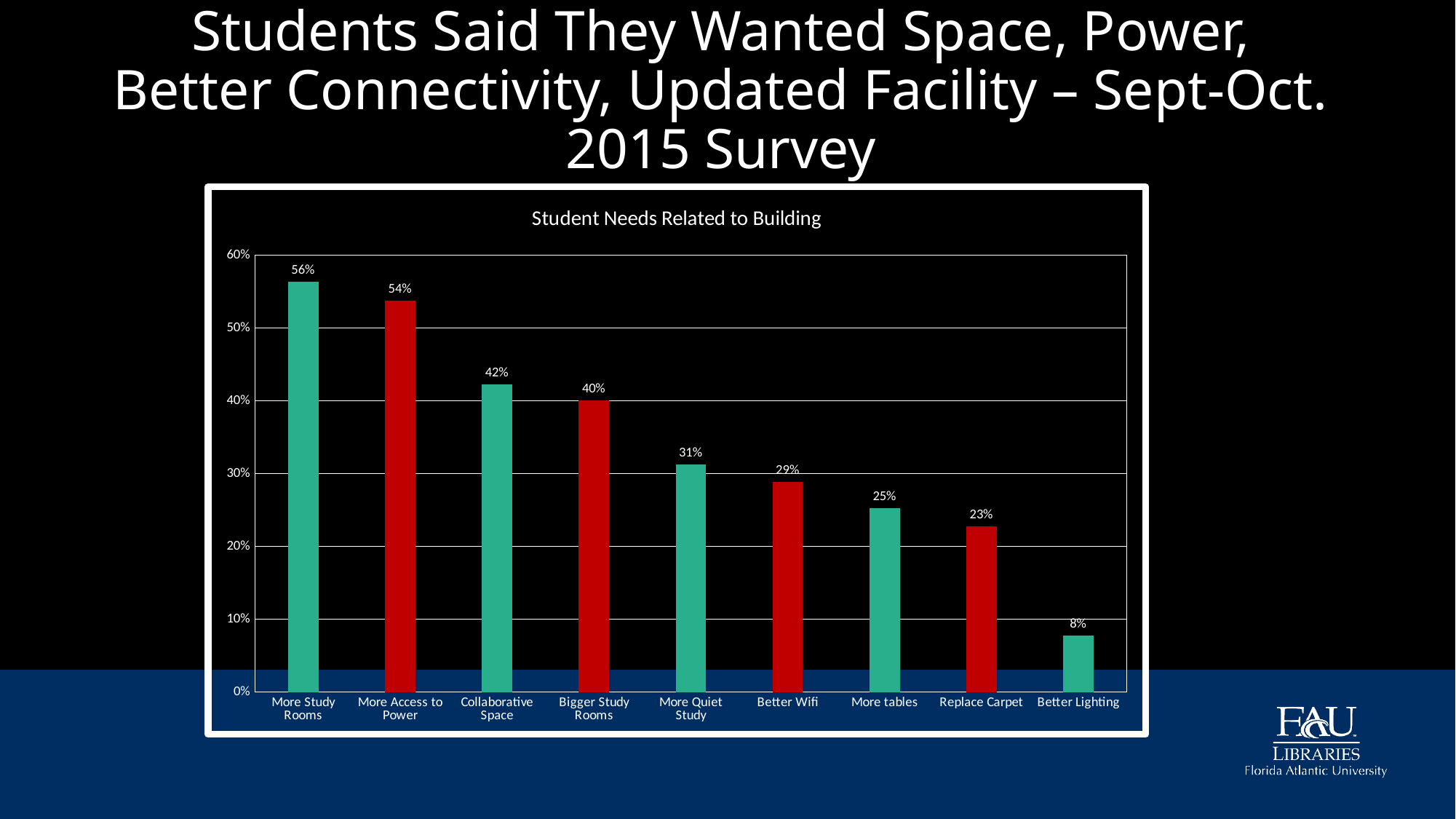
What is the title of the chart? Student Needs Related to Building Is the value for Collaborative Space greater or less than 40%? greater What is the difference between the values for Collaborative Space and Bigger Study Rooms? 2% What is the difference between the values for More Access to Power and Better Lighting? 46% What is the value for Replace Carpet? 23% What is the value for More Study Rooms? 56% How many categories are shown on the x axis? 9 Which category has the highest value? More Study Rooms What is the value for Better Wifi? 29% Which is larger, the value for More Quiet Study or the value for More tables? More Quiet Study Which category has the lowest value? Better Lighting What kind of chart is shown on the slide? bar chart